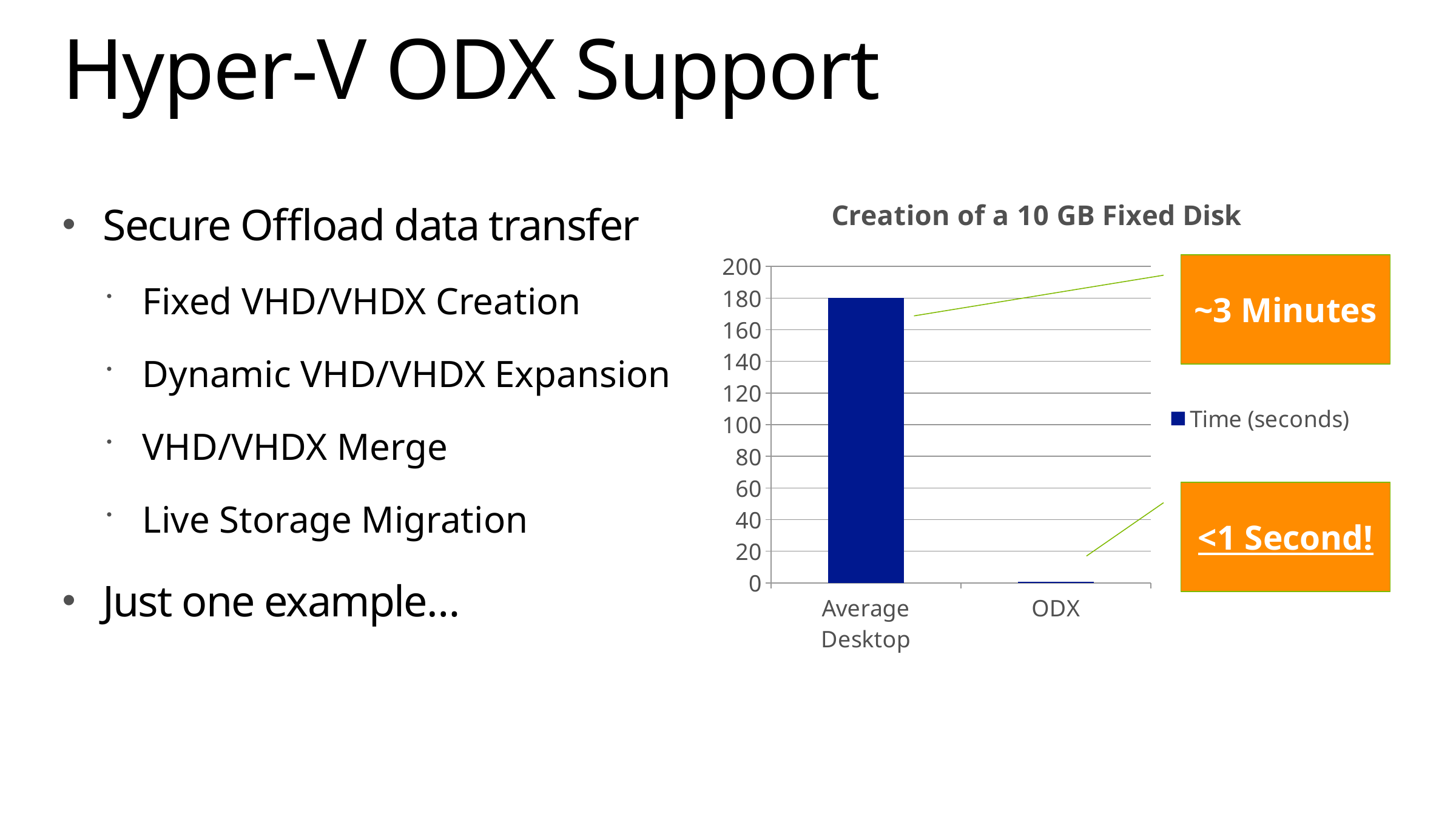
Is the value for ODX greater or less than 20? less What series name is shown in the chart legend? Time (seconds) Is the value for Average Desktop greater or less than 100? greater Which category has the lowest value in the chart? ODX Do the values rise or fall from Average Desktop to ODX along the x axis? fall How many categories are shown on the x axis of the chart? 2 What is the value for Average Desktop in the chart? 180 Which category has the highest value in the chart? Average Desktop Which is larger, the value for Average Desktop or the value for ODX? Average Desktop What kind of chart is shown on the slide? bar chart How many series does the chart legend list? 1 What is the title of the chart? Creation of a 10 GB Fixed Disk